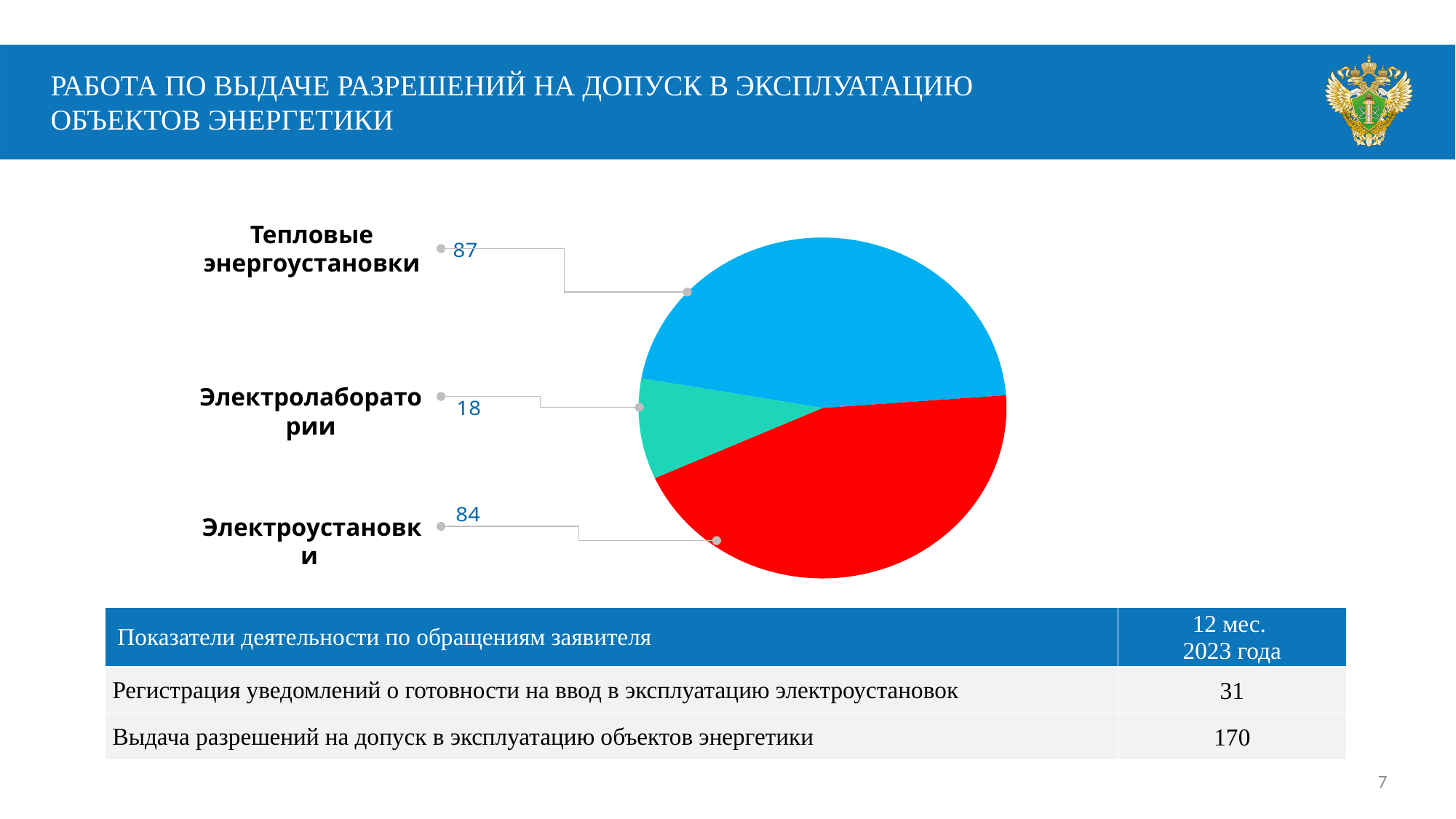
Which category has the largest value in the pie chart? Тепловые энергоустановки What is the difference between the values for Тепловые энергоустановки and Электроустановки? 3 What colour is the slice for Электролаборатории? Green How many categories are shown in the pie chart? 3 What is the difference between the values for Электроустановки and Электролаборатории? 66 What is the value for Электроустановки in the pie chart? 84 Which category has the smallest slice in the pie chart? Электролаборатории Which is larger: the value for Электроустановки or the value for Электролаборатории? Электроустановки What is the value for Электролаборатории in the pie chart? 18 What kind of chart is shown on the slide? Pie chart What is the total of all three values in the pie chart? 189 What is the value for Тепловые энергоустановки in the pie chart? 87